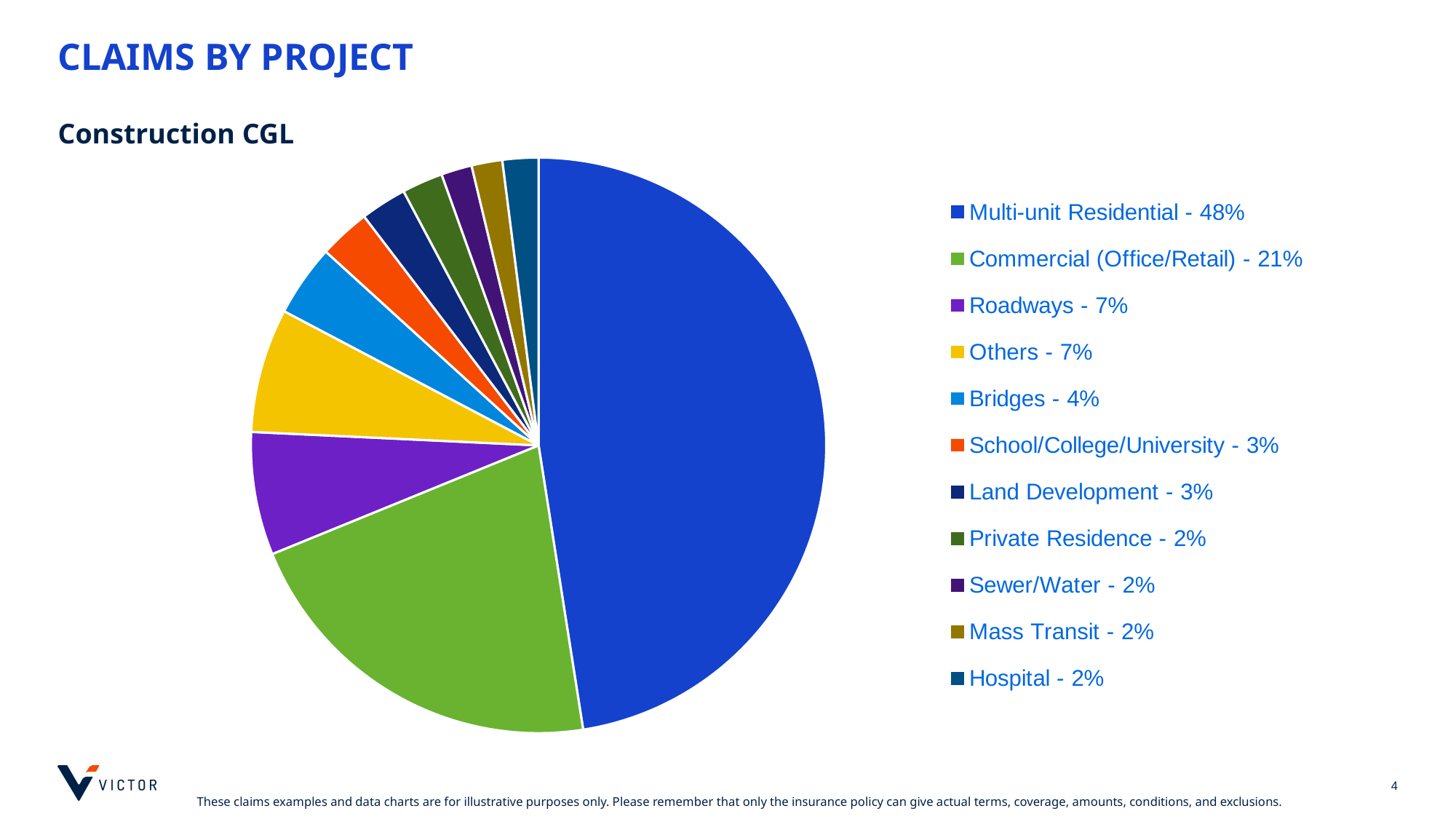
Which project category has the largest share of claims? Multi-unit Residential How many project categories are listed in the legend? 11 What is the difference in share between Multi-unit Residential and Commercial (Office/Retail)? 27% What is the subtitle shown above the pie chart? Construction CGL What share of claims is attributed to Commercial (Office/Retail)? 21% What kind of chart is shown on the slide? Pie chart What share of claims is attributed to Multi-unit Residential? 48% What share of claims is attributed to Bridges? 4% What share of claims is attributed to Land Development? 3% Which has a larger share of claims, Commercial (Office/Retail) or Roadways? Commercial (Office/Retail) Which has a larger share of claims, Bridges or School/College/University? Bridges What is the difference in share between Roadways and Bridges? 3%